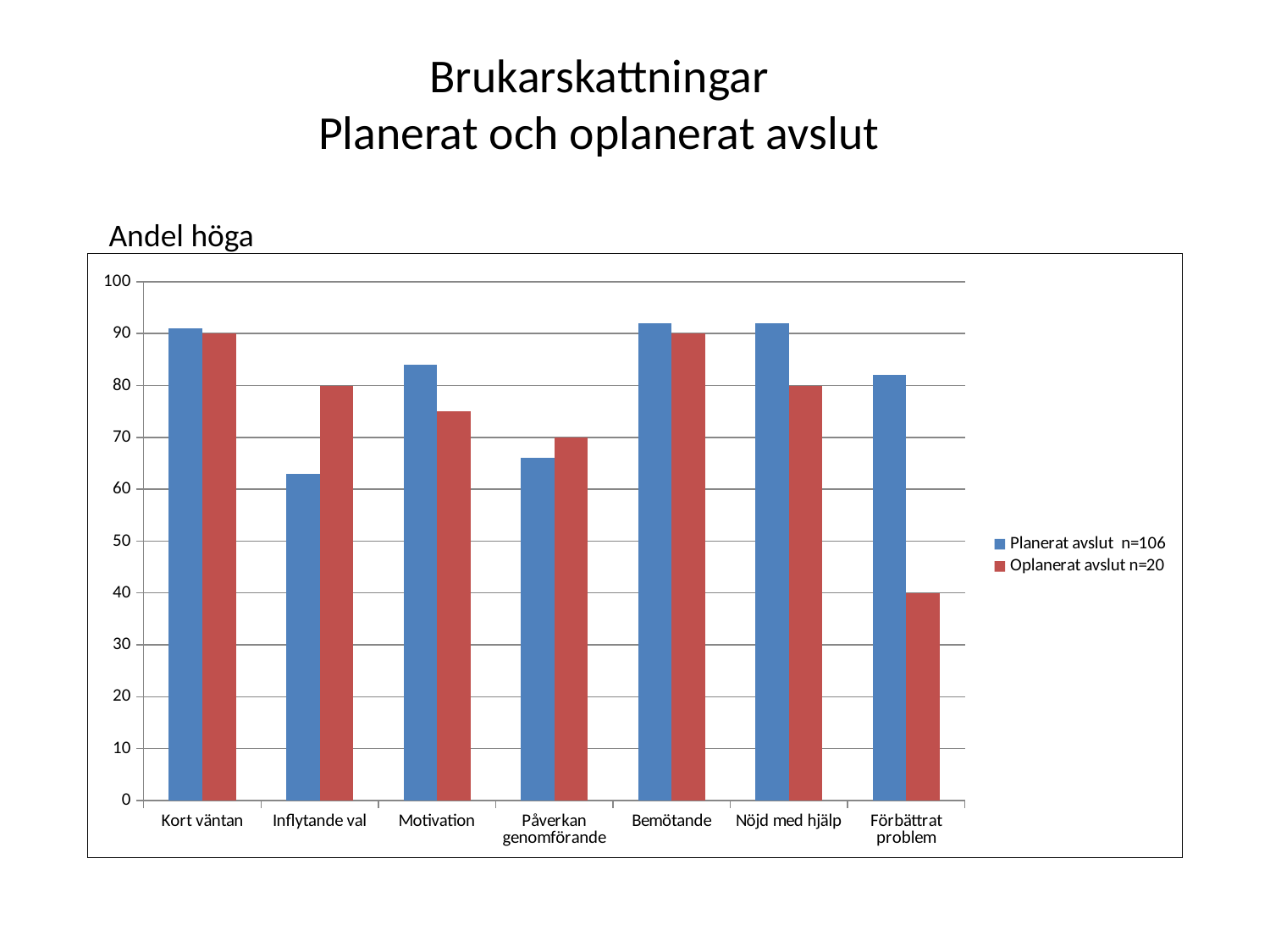
What kind of chart is shown on the slide? bar chart Which is larger in the Förbättrat problem category, Planerat avslut n=106 or Oplanerat avslut n=20? Planerat avslut n=106 Which category has the lowest value for Oplanerat avslut n=20? Förbättrat problem How many series does the legend list? 2 Is the value for Planerat avslut n=106 in the Motivation category greater or less than 80? greater What is the difference between the Oplanerat avslut n=20 values for Inflytande val and Förbättrat problem? 40 How many categories are shown on the x axis of the chart? 7 What is the value for Oplanerat avslut n=20 in the Inflytande val category? 80 What is the value for Oplanerat avslut n=20 in the Förbättrat problem category? 40 Is the value for Planerat avslut n=106 in the Påverkan genomförande category greater or less than 70? less What is the value for Oplanerat avslut n=20 in the Bemötande category? 90 Which is larger in the Inflytande val category, Planerat avslut n=106 or Oplanerat avslut n=20? Oplanerat avslut n=20